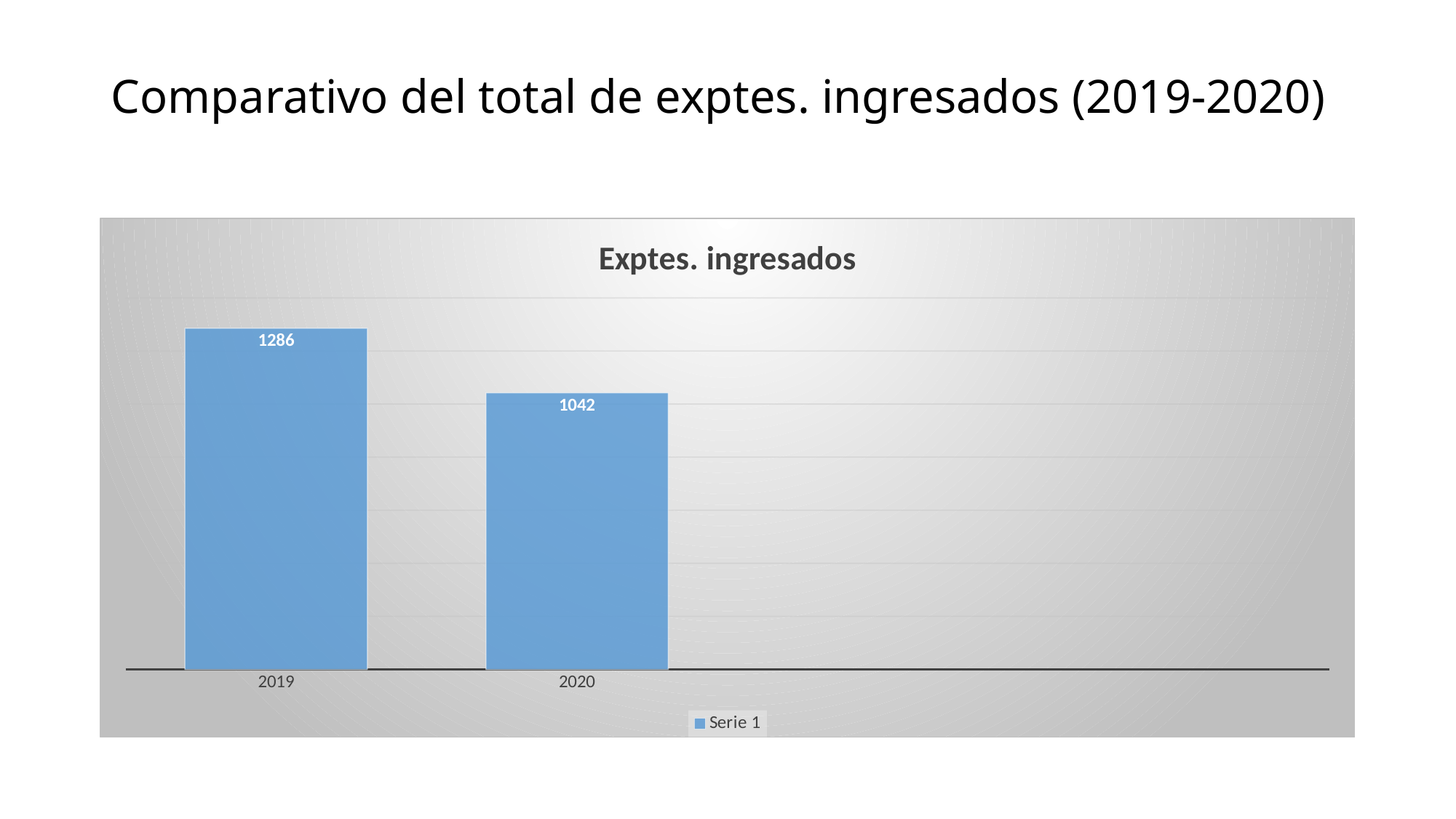
What kind of chart is shown? bar chart What is the name of the series in the legend? Serie 1 How many categories are shown on the x axis? 2 How many series does the legend list? 1 What is the difference between the values for 2019 and 2020? 244 Which is larger, the value for 2019 or the value for 2020? 2019 What is the value for 2019? 1286 Do the values rise or fall from 2019 to 2020? fall Which year has the lowest value? 2020 What is the value for 2020? 1042 What is the title of the chart? Exptes. ingresados Which year has the highest value? 2019